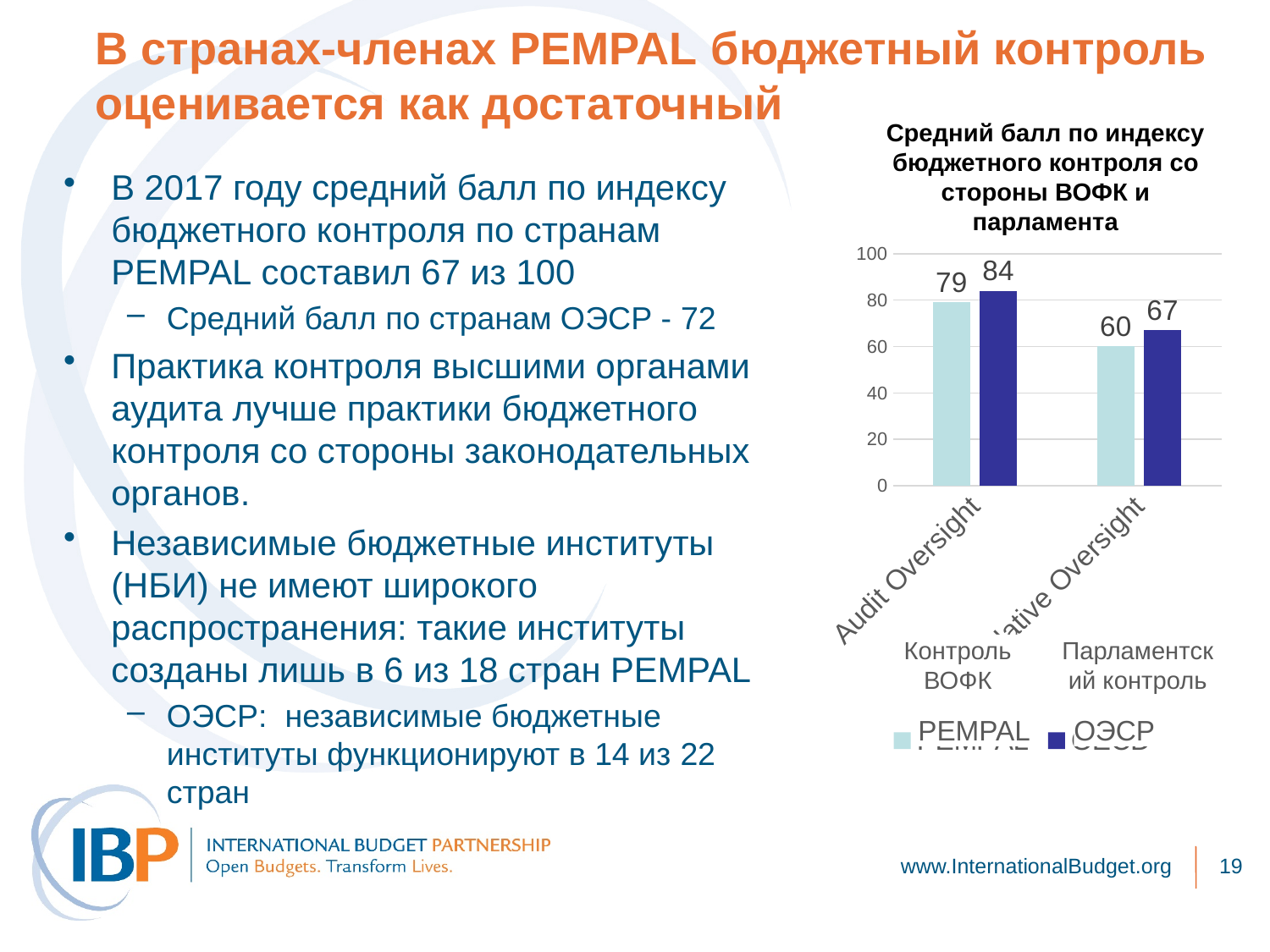
What is the ОЭСР value for Парламентский контроль? 67 What is the PEMPAL value for Парламентский контроль? 60 What is the difference between the ОЭСР and PEMPAL values for Парламентский контроль? 7 Which category has the lowest PEMPAL value? Парламентский контроль What kind of chart is shown on the slide? Bar chart What is the PEMPAL value for Контроль ВОФК (Audit Oversight)? 79 How many series does the legend list? 2 What is the difference between the ОЭСР and PEMPAL values for Контроль ВОФК? 5 What is the ОЭСР value for Контроль ВОФК (Audit Oversight)? 84 Which category has the highest ОЭСР value? Контроль ВОФК (Audit Oversight) Which is larger for Контроль ВОФК: the PEMPAL value or the ОЭСР value? ОЭСР What is the title of the chart? Средний балл по индексу бюджетного контроля со стороны ВОФК и парламента